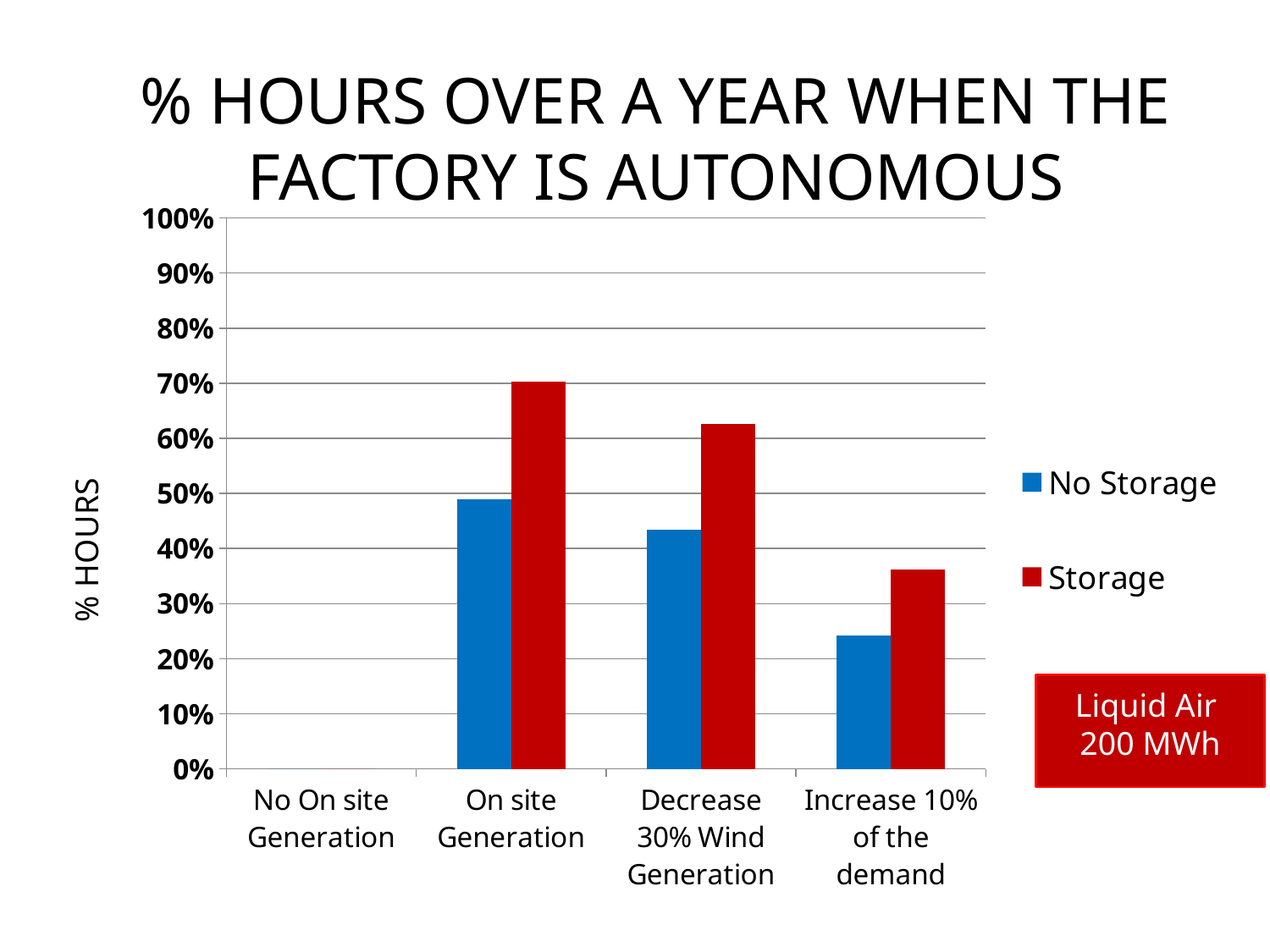
Which category has the highest Storage value? On site Generation Is the Storage value for On site Generation greater or less than 60%? greater Which category has the lowest No Storage value? No On site Generation What kind of chart is shown on the slide? bar chart What is the label of the y axis? % HOURS For Decrease 30% Wind Generation, which series has the larger value, No Storage or Storage? Storage Is the Storage value for Decrease 30% Wind Generation greater or less than 50%? greater How many series does the legend list? 2 Is the No Storage value for Increase 10% of the demand greater or less than 30%? less How many categories are shown on the x axis? 4 Which is larger: the Storage value for Increase 10% of the demand or the No Storage value for On site Generation? No Storage value for On site Generation